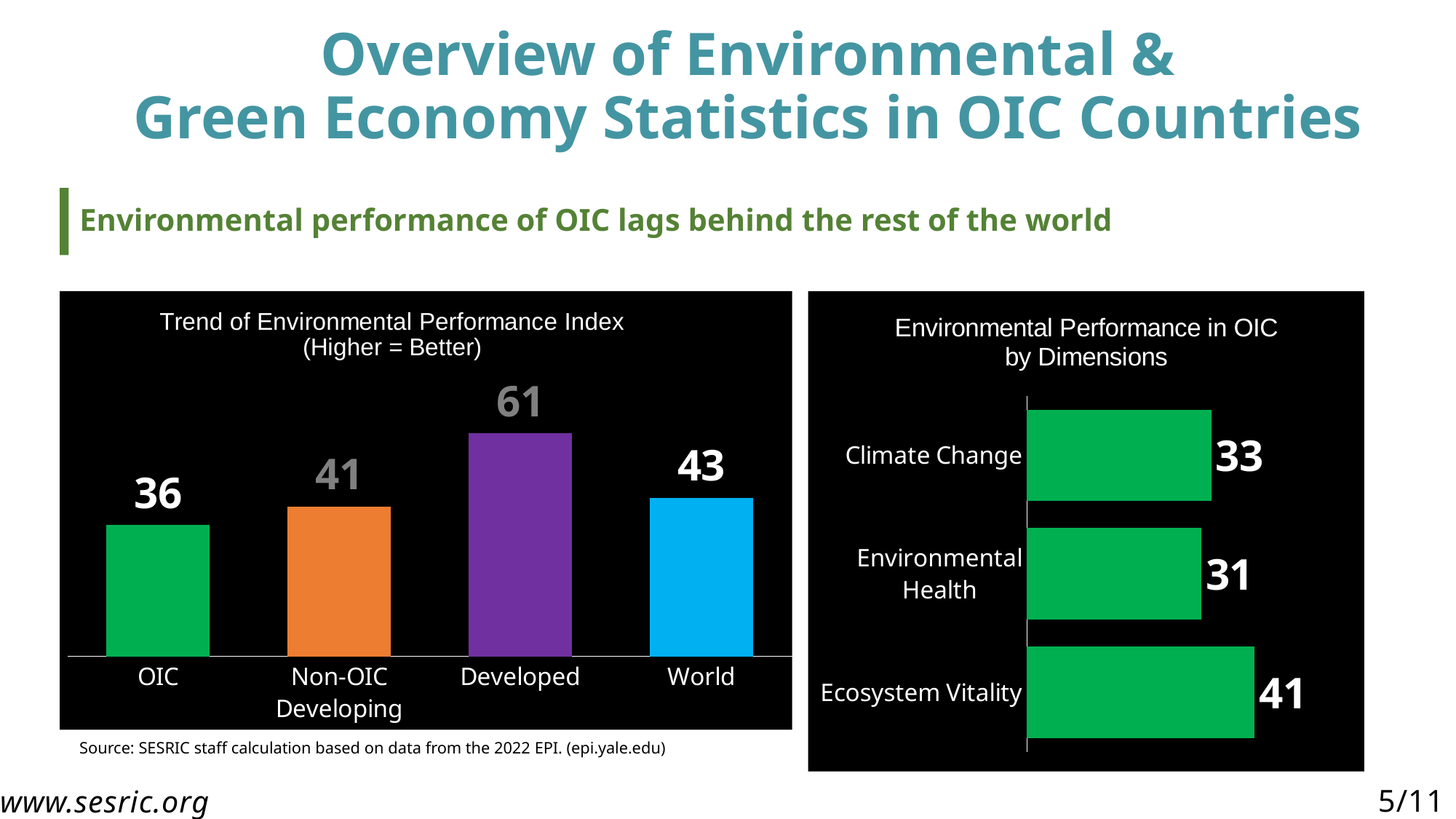
How many categories are shown in the 'Trend of Environmental Performance Index' chart? 4 In the 'Trend of Environmental Performance Index' chart, what is the value for OIC? 36 In the 'Trend of Environmental Performance Index' chart, which category has the lowest value? OIC In the 'Environmental Performance in OIC by Dimensions' chart, which dimension has the highest value? Ecosystem Vitality In the 'Trend of Environmental Performance Index' chart, which is larger, Non-OIC Developing or World? World What kind of chart is the 'Environmental Performance in OIC by Dimensions' chart? Bar chart In the 'Trend of Environmental Performance Index' chart, which category has the highest value? Developed In the 'Trend of Environmental Performance Index' chart, what colour is the Developed bar? Purple In the 'Environmental Performance in OIC by Dimensions' chart, what is the difference between Ecosystem Vitality and Climate Change? 8 In the 'Environmental Performance in OIC by Dimensions' chart, what is the value for Environmental Health? 31 In the 'Trend of Environmental Performance Index' chart, what is the value for Developed? 61 In the 'Trend of Environmental Performance Index' chart, what is the difference between the Developed and OIC values? 25